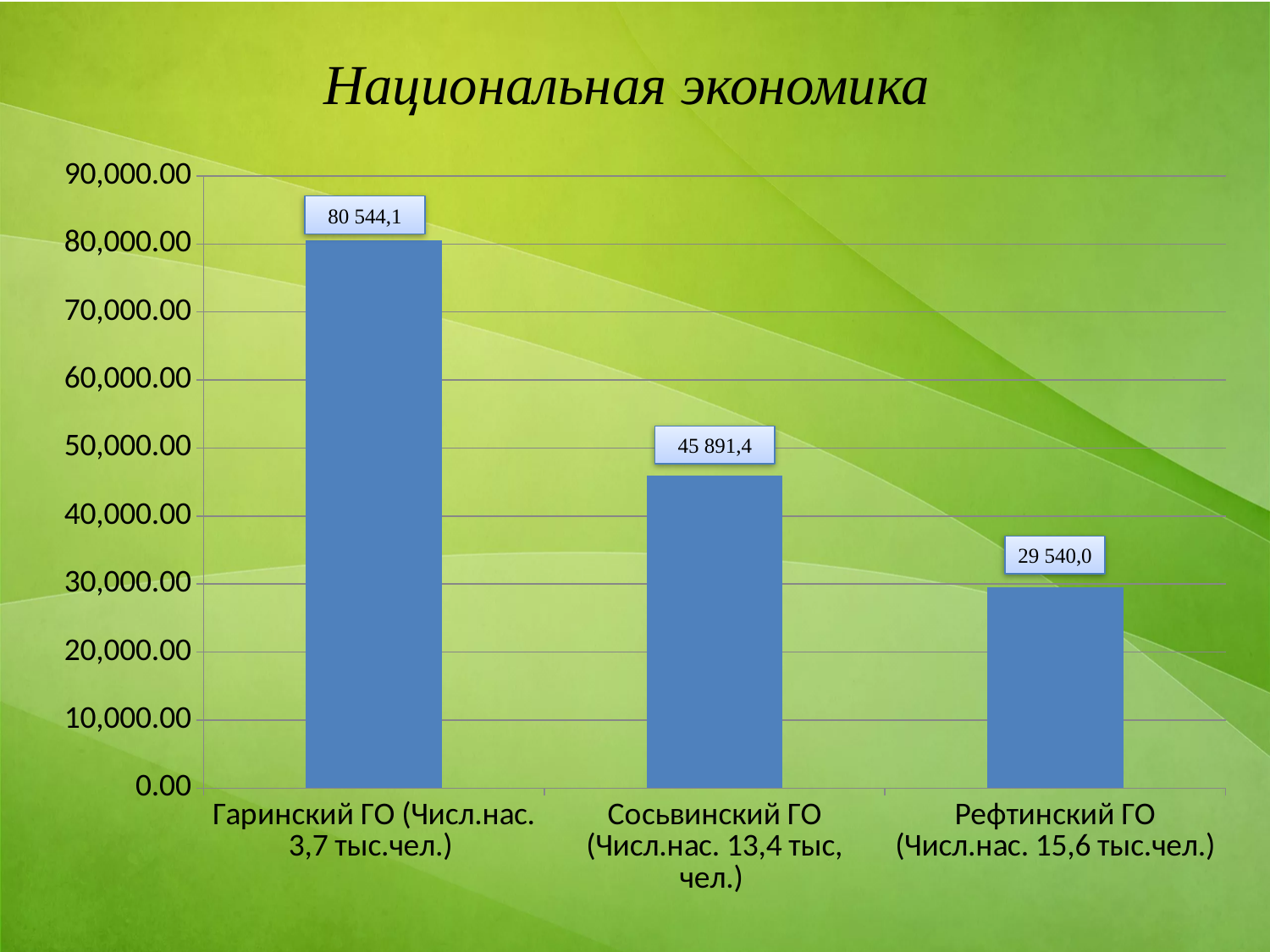
What is the value for Сосьвинский ГО? 45 891,4 What is the value for Рефтинский ГО? 29 540,0 How many categories are shown in the chart? 3 Which category has the highest value? Гаринский ГО What is the difference between the values for Сосьвинский ГО and Рефтинский ГО? 16 351,4 What is the title of the slide? Национальная экономика What kind of chart is shown on the slide? bar chart Which category has the lowest value? Рефтинский ГО What is the difference between the values for Гаринский ГО and Сосьвинский ГО? 34 652,7 What is the value for Гаринский ГО? 80 544,1 Which is larger, the value for Сосьвинский ГО or the value for Рефтинский ГО? Сосьвинский ГО Is the value for Рефтинский ГО greater or less than 30,000.00? less